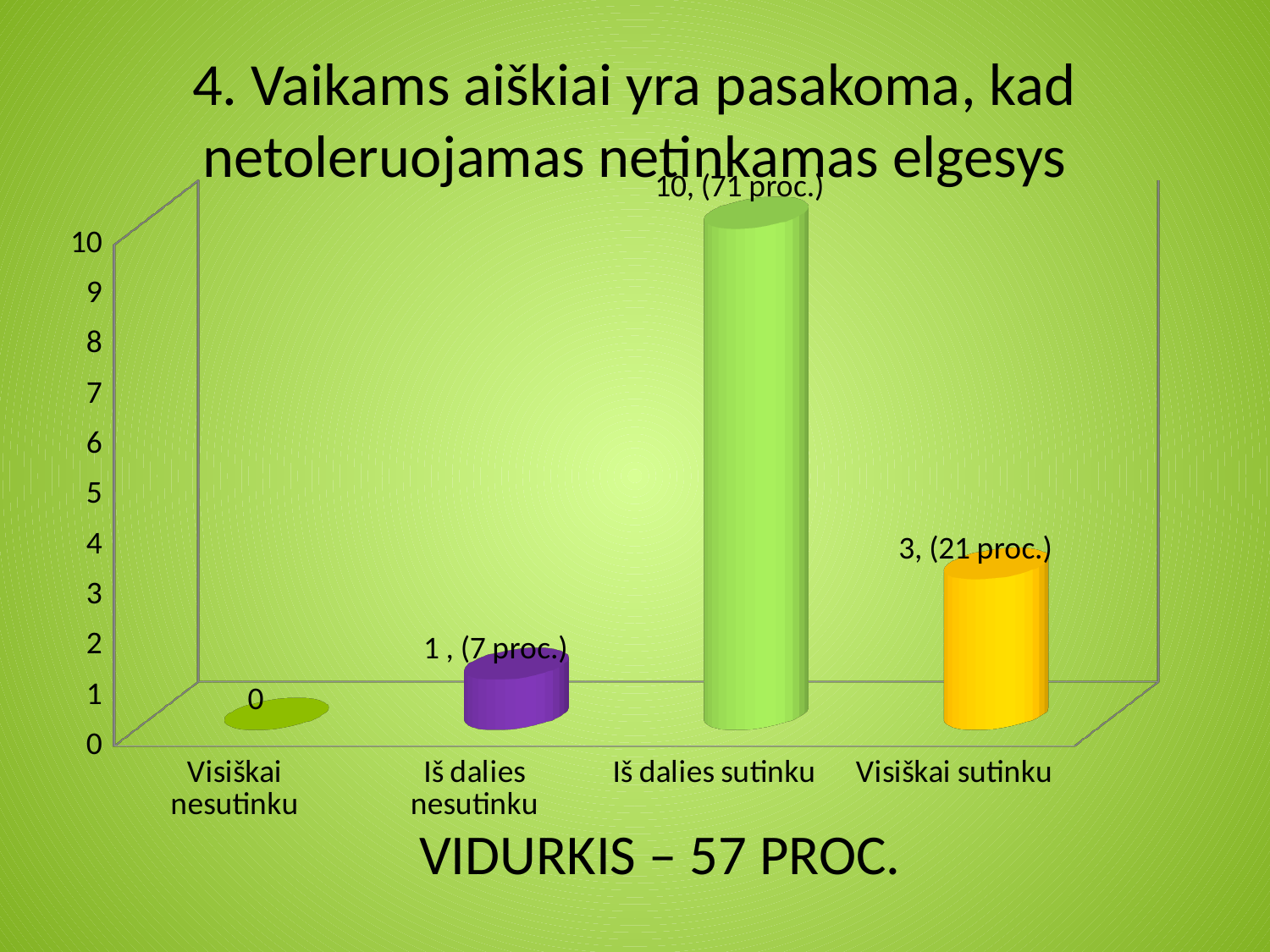
What value is shown for "Visiškai nesutinku"? 0 How many categories are shown on the x axis? 4 What is the difference between the counts for "Iš dalies sutinku" and "Visiškai sutinku"? 7 What average (VIDURKIS) is stated below the chart? 57 PROC. What value is shown for "Iš dalies nesutinku"? 1 , (7 proc.) Which is larger, the value for "Visiškai sutinku" or the value for "Iš dalies nesutinku"? Visiškai sutinku What value is shown for "Iš dalies sutinku"? 10, (71 proc.) What value is shown for "Visiškai sutinku"? 3, (21 proc.) What kind of chart is shown on the slide? bar chart Which category has the highest value? Iš dalies sutinku Is the value for "Iš dalies sutinku" greater or less than 5? greater Which category has the lowest value? Visiškai nesutinku